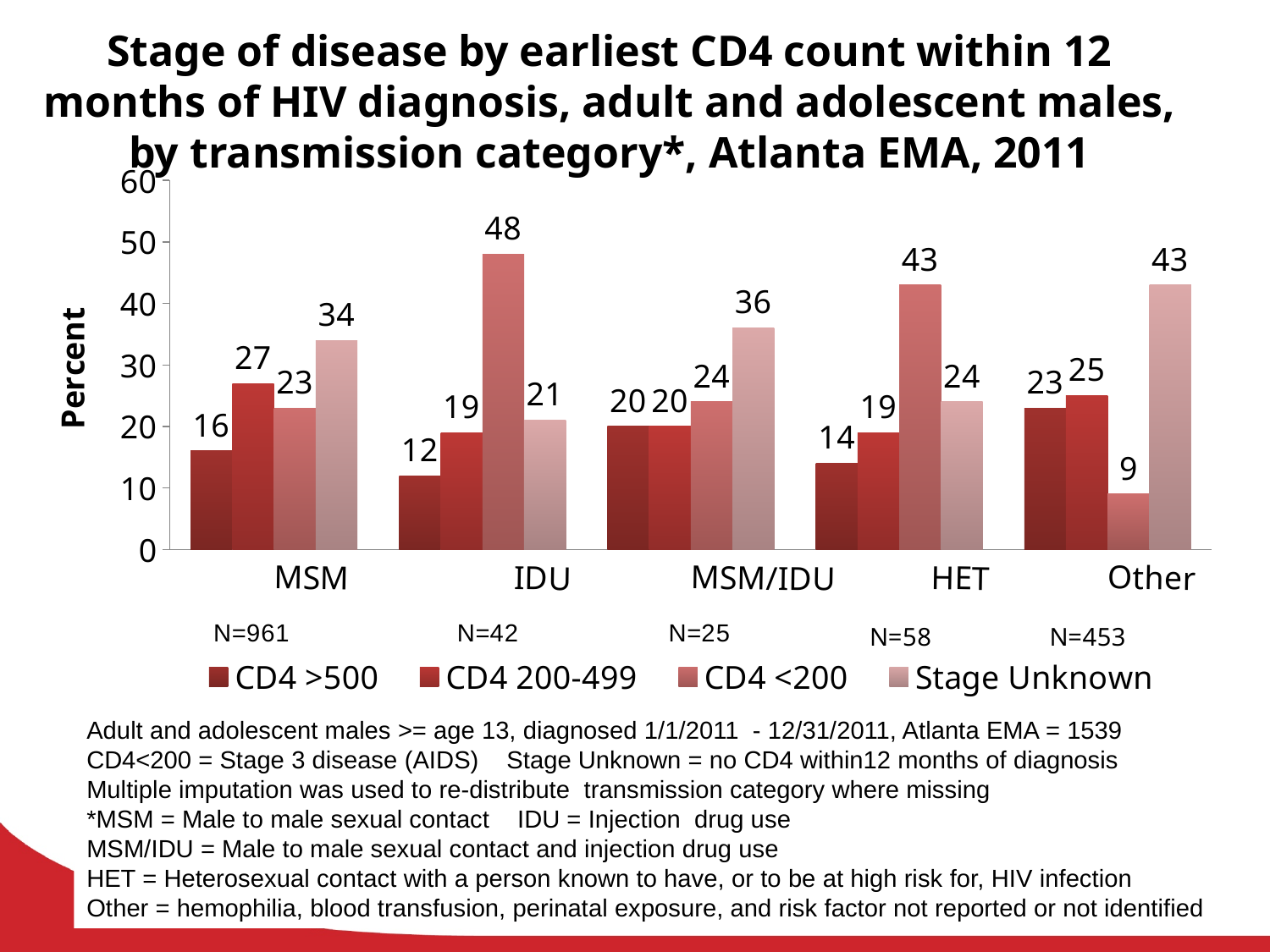
What kind of chart is shown on the slide? Bar chart What is the value for Stage Unknown in the MSM category? 34 What is the difference between the Stage Unknown value for Other and the Stage Unknown value for IDU? 22 Which transmission category has the highest value for CD4 <200? IDU What is the value for CD4 >500 in the HET category? 14 Which transmission category has the lowest value for CD4 >500? IDU What is the value for CD4 <200 in the Other category? 9 What is the value for CD4 <200 in the IDU category? 48 How many transmission categories are shown on the x axis? 5 What is the label of the y axis? Percent How many series does the legend list? 4 Which is larger in the MSM category: CD4 200-499 or CD4 <200? CD4 200-499